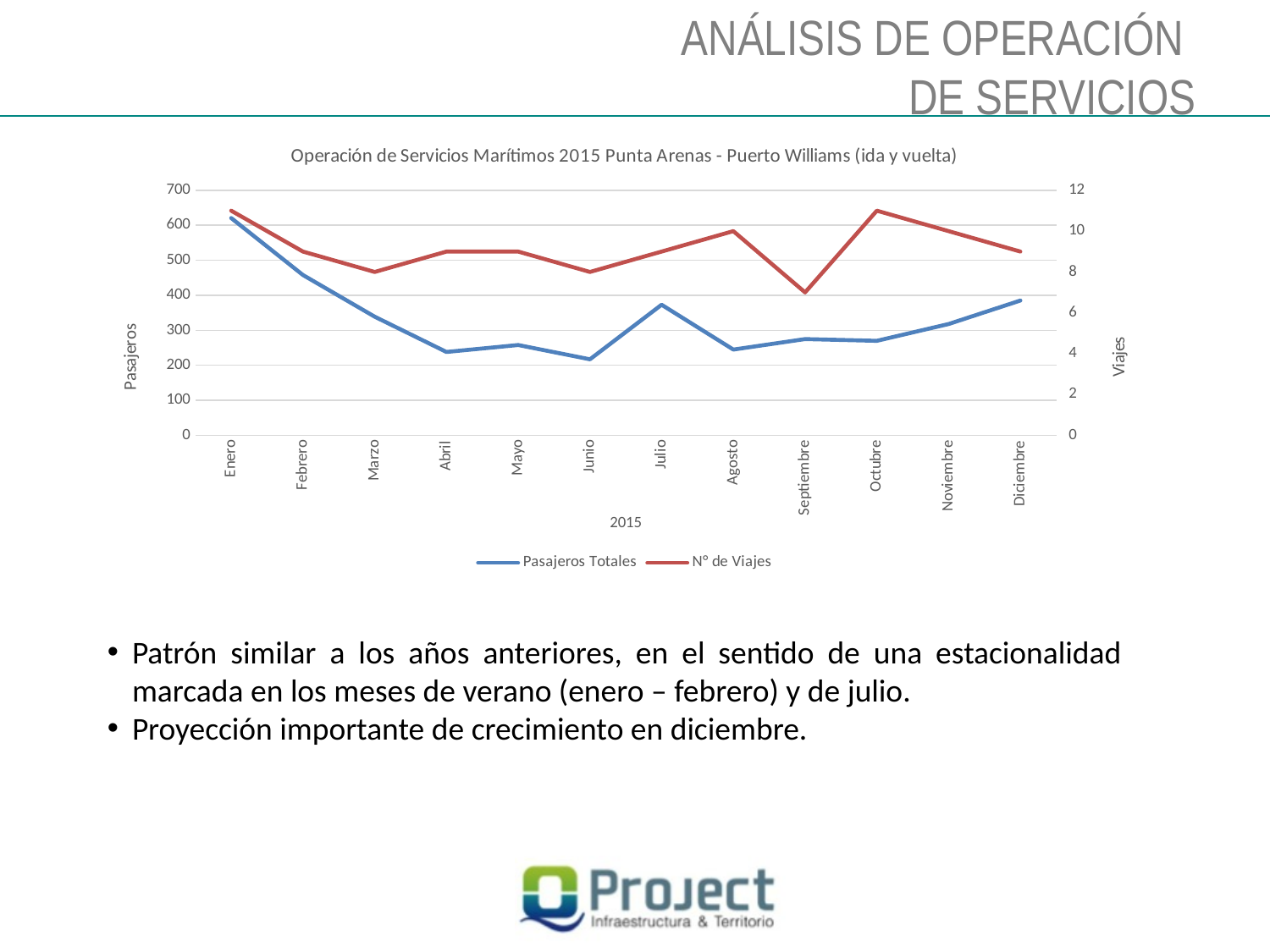
Is the value of Pasajeros Totales for Julio greater or less than 300? greater In which month is N° de Viajes lowest? Septiembre In which month is Pasajeros Totales lowest? Junio Does Pasajeros Totales rise or fall from Enero to Abril? fall What kind of chart is shown on the slide? line chart Which month has more Pasajeros Totales, Julio or Agosto? Julio How many series does the legend list? 2 Is the value of N° de Viajes for Septiembre greater or less than 8? less In which month is Pasajeros Totales highest? Enero Is the value of Pasajeros Totales for Junio greater or less than 300? less How many months are plotted along the x axis? 12